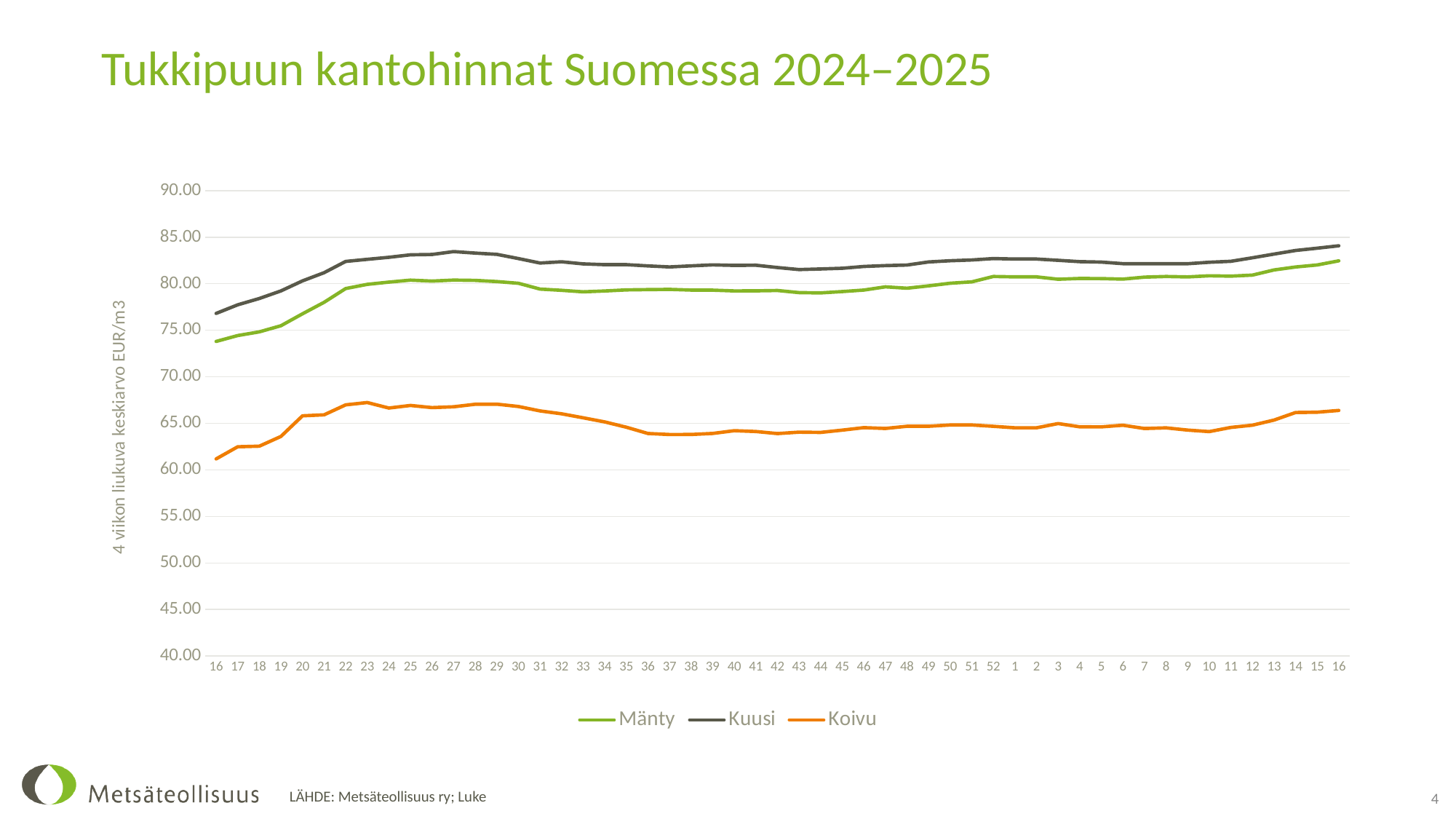
Does the Koivu line rise or fall from week 16 to week 23? rise How many week labels are shown on the x axis? 53 Is the value for Mänty at the first week 16 greater or less than 75.00? less Is the value for Koivu at week 16 (the first point) greater or less than 65.00? less What kind of chart is shown on the slide? line chart At week 30, which is larger, the value for Kuusi or the value for Mänty? Kuusi Which series has the highest values throughout the chart? Kuusi Which series has the lowest values throughout the chart? Koivu Is the value for Mänty at the last week 16 greater or less than 80.00? greater How many series does the legend list? 3 What is the title of the chart? Tukkipuun kantohinnat Suomessa 2024–2025